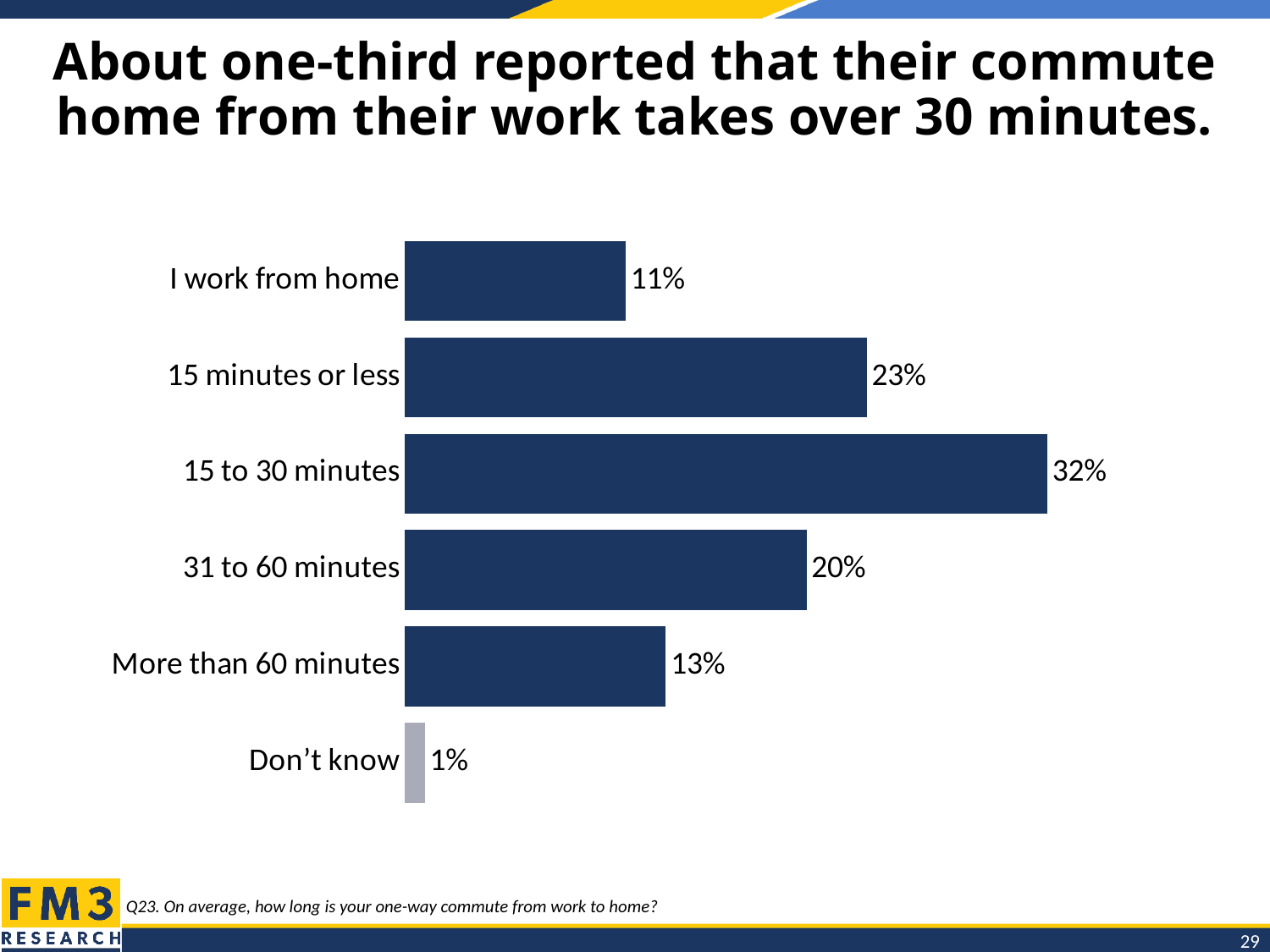
What type of chart is shown on the slide? Bar chart What is the combined percentage of respondents with a commute of 31 to 60 minutes and more than 60 minutes? 33% What is the difference in percentage points between the 15 to 30 minutes category and the 31 to 60 minutes category? 12 Which is larger: the percentage for 15 minutes or less or the percentage for more than 60 minutes? 15 minutes or less Which commute category has the highest percentage? 15 to 30 minutes What percentage of respondents reported a commute of 31 to 60 minutes? 20% What percentage of respondents reported a commute of more than 60 minutes? 13% What percentage of respondents reported a commute of 15 minutes or less? 23% What percentage of respondents said they work from home? 11% Which bar is shown in a different colour (grey) from the others? Don't know Which category has the lowest percentage? Don't know How many categories are shown in the chart? 6